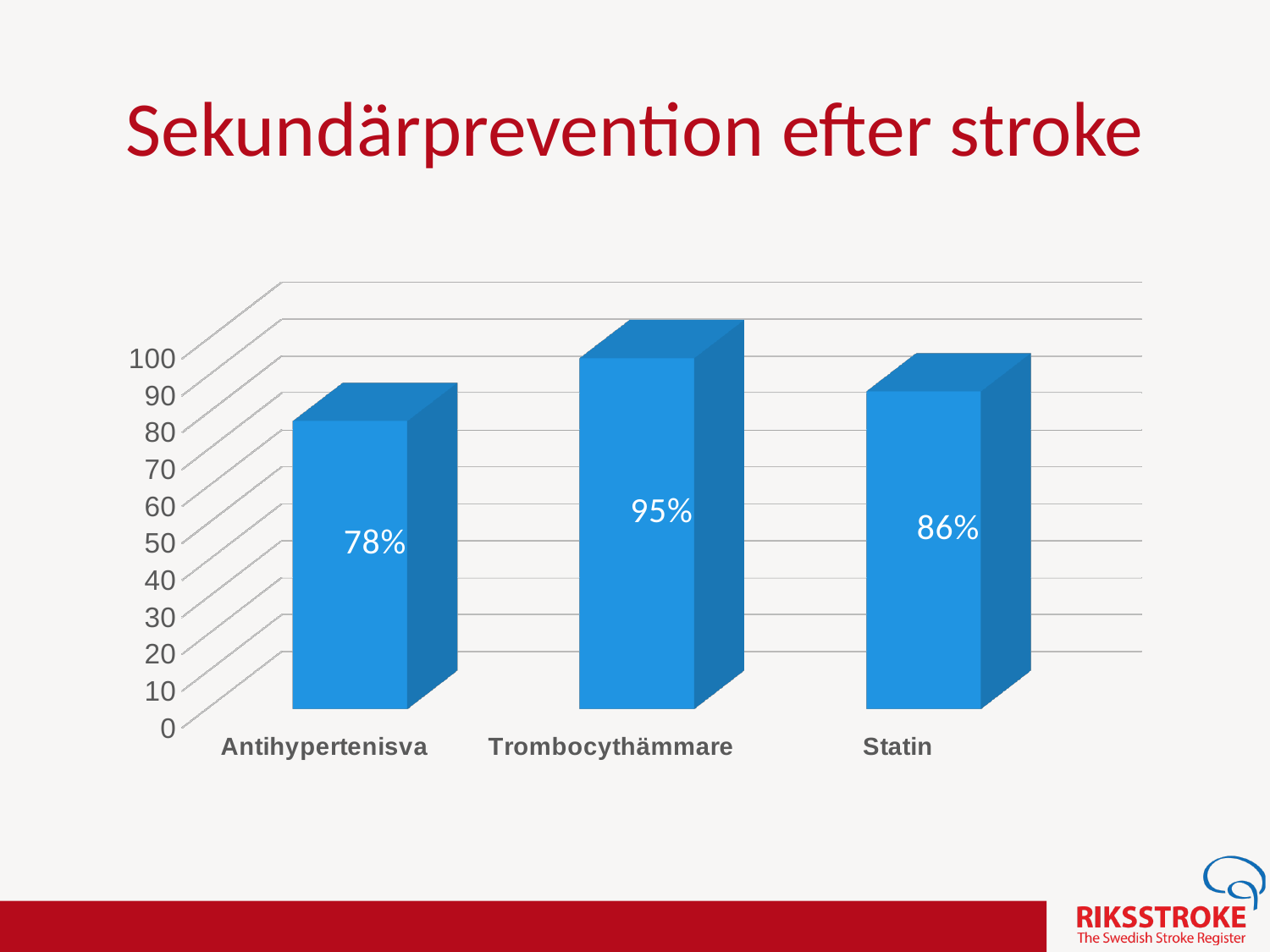
What is the value for Antihypertenisva? 78% Which category has the highest value? Trombocythämmare What is the value for Statin? 86% What is the title of the slide? Sekundärprevention efter stroke Which is larger, the value for Statin or the value for Antihypertenisva? Statin What kind of chart is shown on the slide? bar chart What is the value for Trombocythämmare? 95% What is the difference between the values for Statin and Antihypertenisva? 8% Is the value for Statin greater or less than 80? greater What is the difference between the values for Trombocythämmare and Antihypertenisva? 17% Which category has the lowest value? Antihypertenisva How many categories are shown in the chart? 3